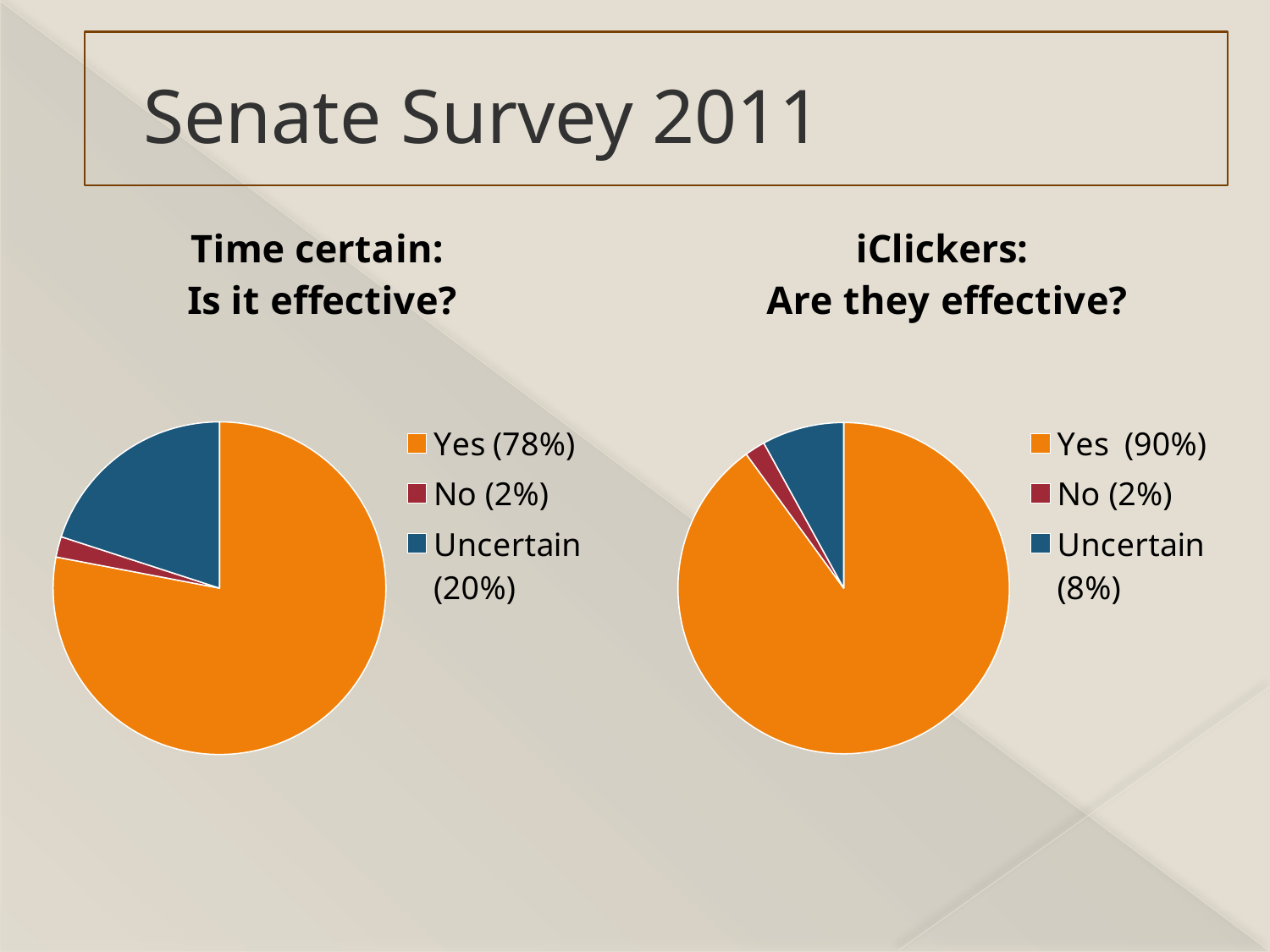
What is the title of the slide containing the two pie charts? Senate Survey 2011 In the 'Time certain: Is it effective?' chart, what is the difference between the Yes and Uncertain shares? 58% In the 'iClickers: Are they effective?' chart, what share of responses is Uncertain? 8% What kind of chart is the 'Time certain: Is it effective?' chart? Pie chart Is the Uncertain share larger in the 'Time certain' chart or the 'iClickers' chart? Time certain In the 'Time certain: Is it effective?' chart, what share of responses is Yes? 78% How many categories does the 'iClickers: Are they effective?' chart show? 3 In the 'Time certain: Is it effective?' chart, which category has the largest slice? Yes In the 'Time certain: Is it effective?' chart, what colour is the Uncertain slice? Blue In the 'iClickers: Are they effective?' chart, which category has the smallest slice? No In the 'iClickers: Are they effective?' chart, what share of responses is No? 2% What is the difference between the Yes share in the 'iClickers' chart and the Yes share in the 'Time certain' chart? 12%